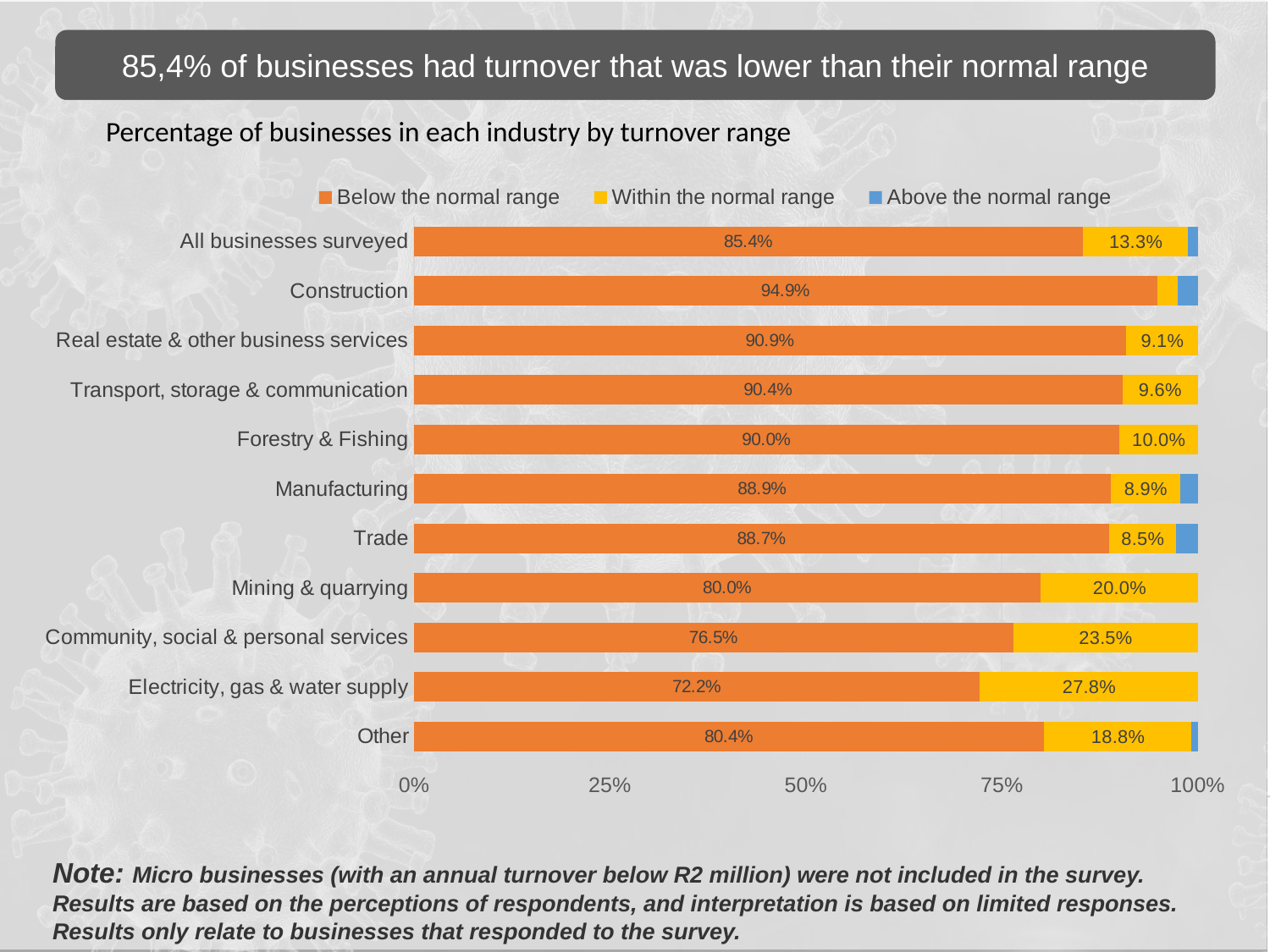
Which industry has the highest percentage of businesses with turnover below the normal range? Construction Is the percentage of Construction businesses with turnover within the normal range greater or less than 25%? less What percentage of Electricity, gas & water supply businesses had turnover within the normal range? 27.8% What is the difference in percentage points between Construction and Electricity, gas & water supply for turnover below the normal range? 22.7 Which industry has the highest percentage of businesses with turnover within the normal range? Electricity, gas & water supply Which has a larger share of businesses with turnover within the normal range, Mining & quarrying or Trade? Mining & quarrying What percentage of Mining & quarrying businesses had turnover below the normal range? 80.0% How many industry categories (including All businesses surveyed) are shown on the chart? 11 What percentage of all businesses surveyed had turnover below the normal range? 85.4% Which industry has the lowest percentage of businesses with turnover below the normal range? Electricity, gas & water supply What type of chart is shown on the slide? Stacked bar chart How many series does the legend list? 3